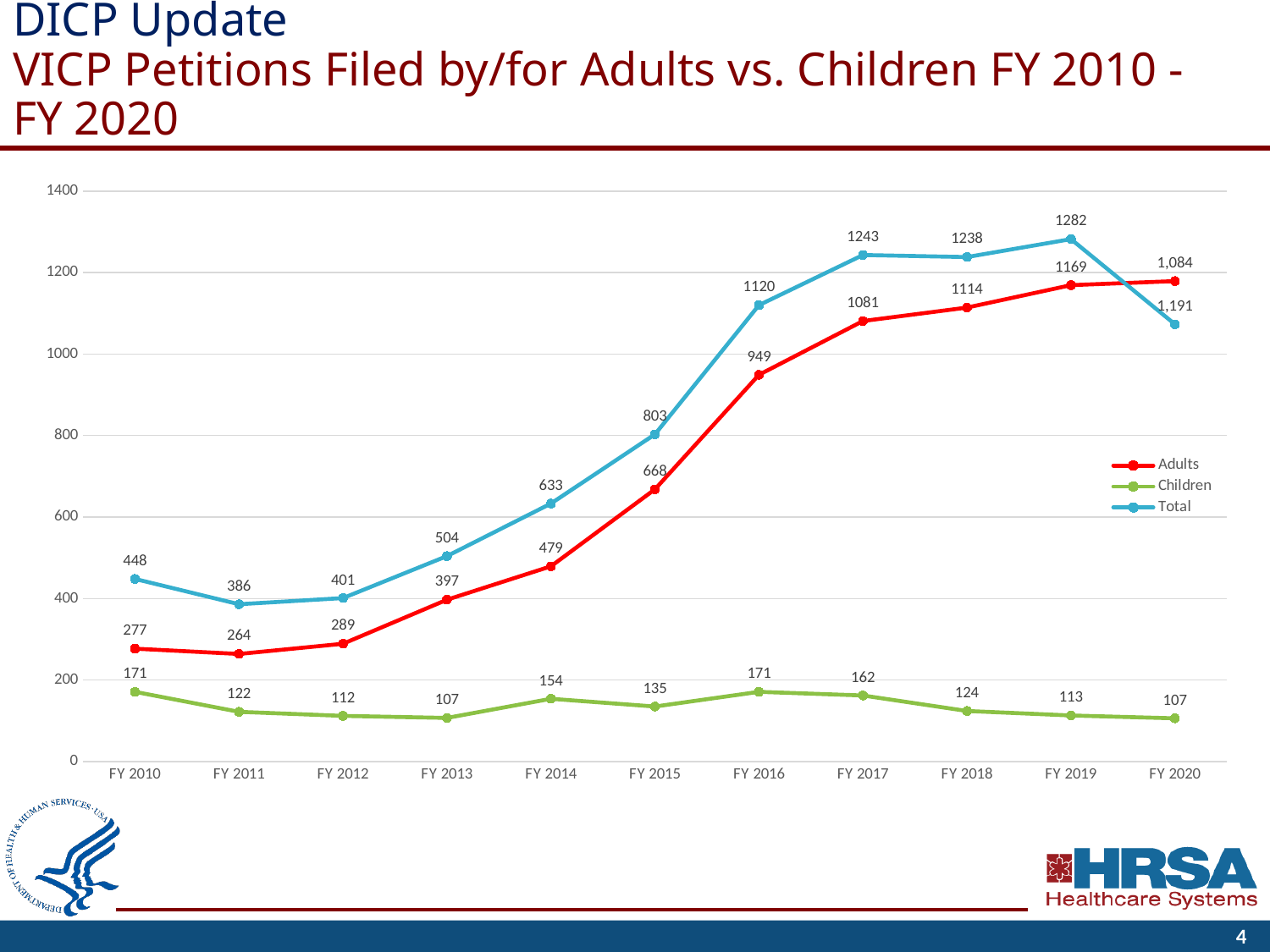
What is the value for Adults in FY 2016? 949 What is the difference between the Adults values for FY 2017 and FY 2016? 132 In which fiscal year is the Adults series at its lowest? FY 2011 Does the Adults series rise or fall from FY 2012 to FY 2019? rise What is the Total value in FY 2013? 504 Is the Total value for FY 2014 greater or less than 600? greater How many fiscal years are plotted along the x axis? 11 What is the value for Children in FY 2014? 154 What kind of chart is shown on the slide? line chart How many series does the legend list? 3 In which fiscal year is the Total series at its highest? FY 2019 Which is larger, the Total value for FY 2011 or for FY 2012? FY 2012